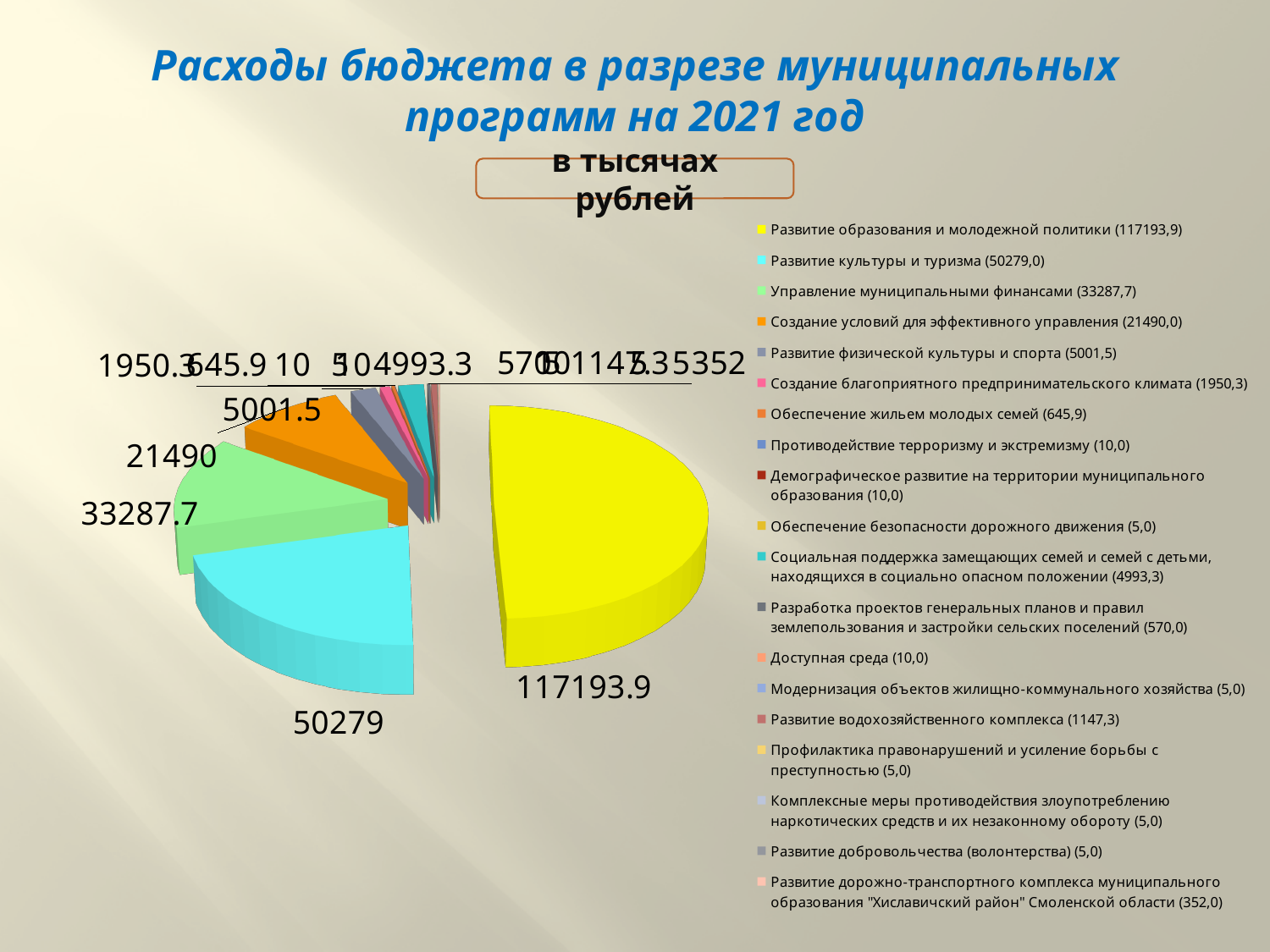
Which program has the largest slice of the pie? Развитие образования и молодежной политики Which is larger: the value for Управление муниципальными финансами or Создание условий для эффективного управления? Управление муниципальными финансами What is the value for Управление муниципальными финансами? 33287.7 What type of chart is shown on the slide? pie chart What is the value for Создание условий для эффективного управления? 21490 In what units are the values on the chart expressed, according to the label above the chart? в тысячах рублей According to the legend, what is the value for Развитие водохозяйственного комплекса? 1147,3 How many programs does the legend list? 19 What is the difference between the values for Развитие образования и молодежной политики and Развитие культуры и туризма? 66914.9 What is the difference between the values for Развитие культуры и туризма and Управление муниципальными финансами? 16991.3 What is the value for Развитие культуры и туризма? 50279 What is the value for Развитие образования и молодежной политики? 117193.9